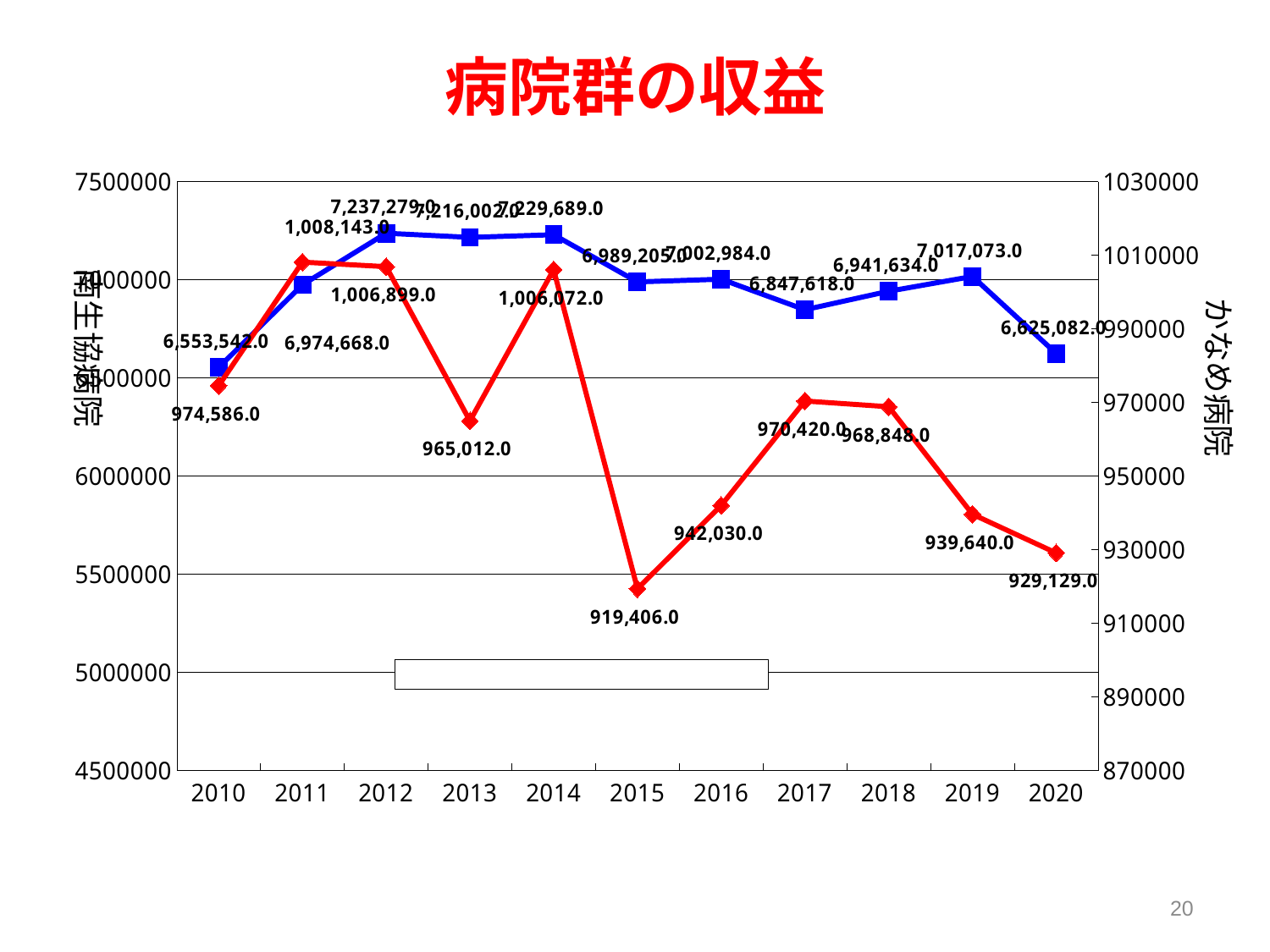
What is the difference between the かなめ病院 values for 2017 and 2018? 1,572.0 What kind of chart is shown on the slide? line chart What is the title of the chart? 病院群の収益 What is the value for 南生協病院 in 2010? 6,553,542.0 Does the value for かなめ病院 rise or fall from 2017 to 2020? fall What is the value for 南生協病院 in 2017? 6,847,618.0 What is the value for かなめ病院 in 2015? 919,406.0 What is the difference between the 南生協病院 values for 2019 and 2020? 391,991.0 How many years are plotted along the x axis? 11 In which year is the value for かなめ病院 highest? 2011 In which year is the value for かなめ病院 lowest? 2015 Which year has the larger value for 南生協病院, 2018 or 2019? 2019